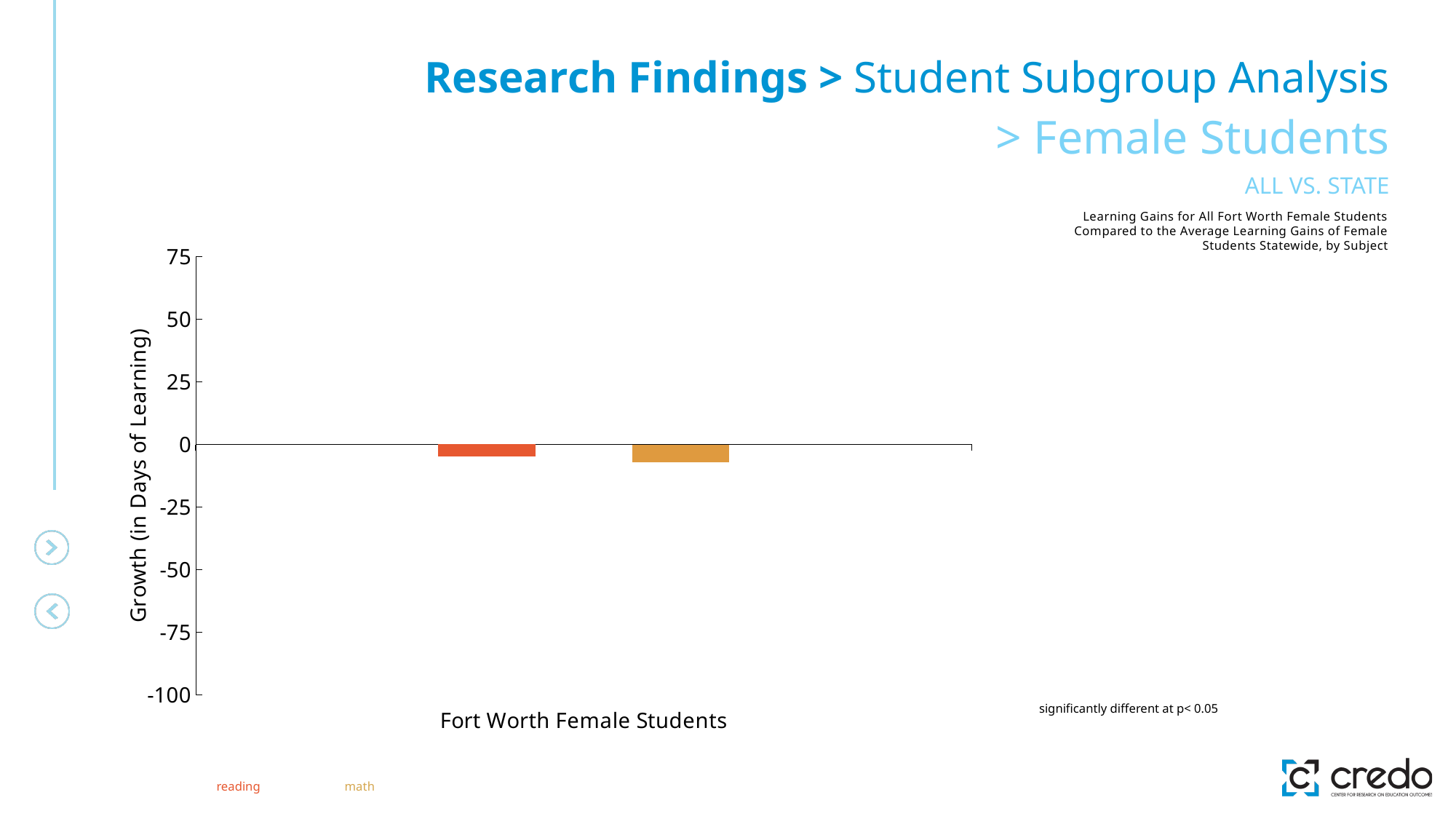
Is the value for math greater or less than -25? greater What are the two series named in the legend? reading and math Is the value for math greater or less than 0? less Is the value for reading greater or less than -25? greater How many categories are shown on the x axis? 1 What is the label on the vertical axis? Growth (in Days of Learning) What kind of chart is shown on the slide? bar chart How many series does the legend list? 2